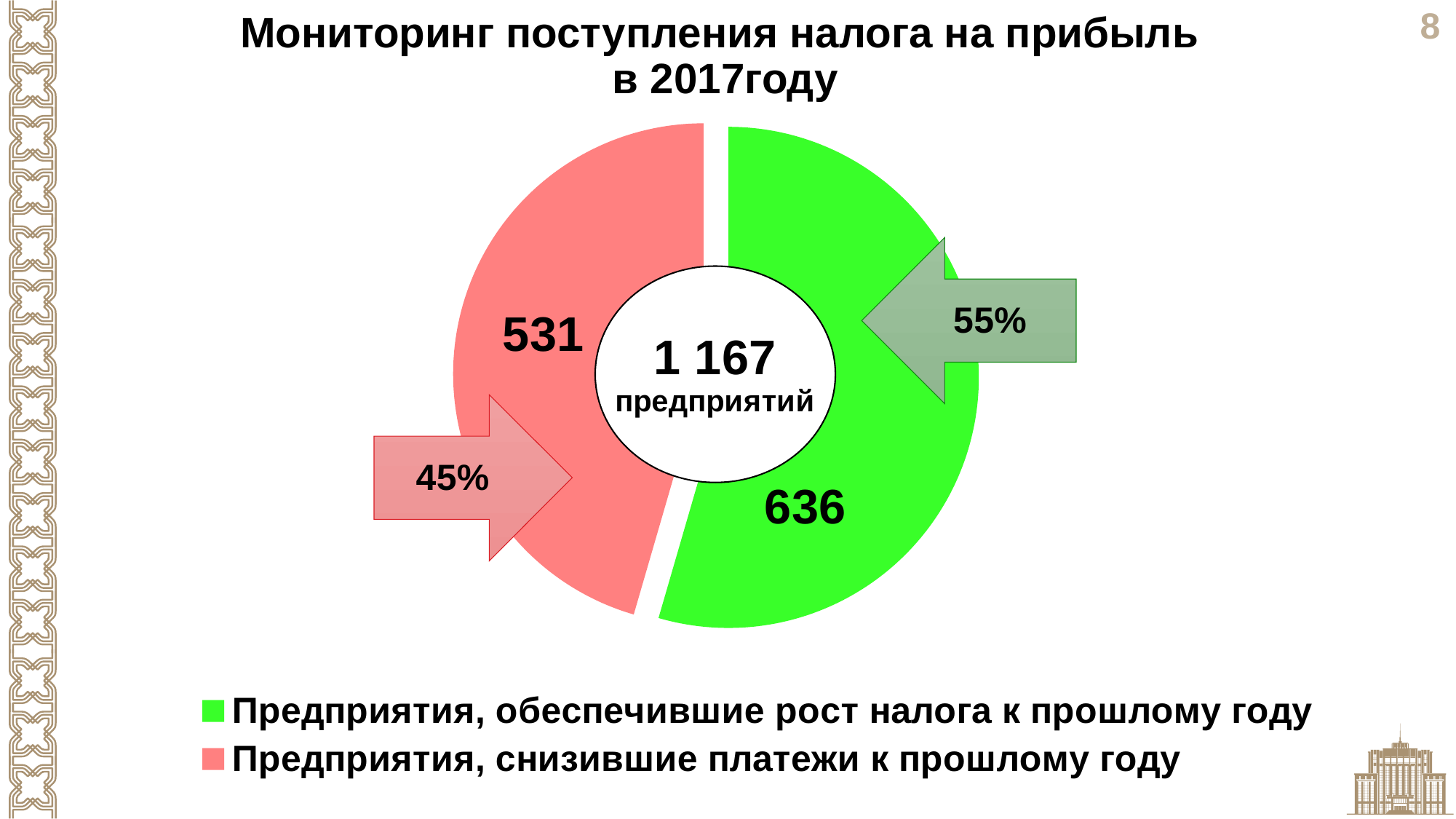
Which category has the smaller number of enterprises? Предприятия, снизившие платежи к прошлому году How many slices does the pie chart have? 2 What share of the pie do the enterprises that decreased payments represent? 45% What colour is the slice for "Предприятия, снизившие платежи к прошлому году"? red (pink) Which category has the larger number of enterprises? Предприятия, обеспечившие рост налога к прошлому году What share of the pie do the enterprises that increased tax payments represent? 55% How many entries does the legend list? 2 How many enterprises are in the category "Предприятия, снизившие платежи к прошлому году"? 531 What is the difference between the number of enterprises that increased tax payments (636) and those that decreased payments (531)? 105 How many enterprises are in the category "Предприятия, обеспечившие рост налога к прошлому году"? 636 What kind of chart is shown on the slide? pie chart What is the total number of enterprises shown in the centre of the chart? 1 167 предприятий